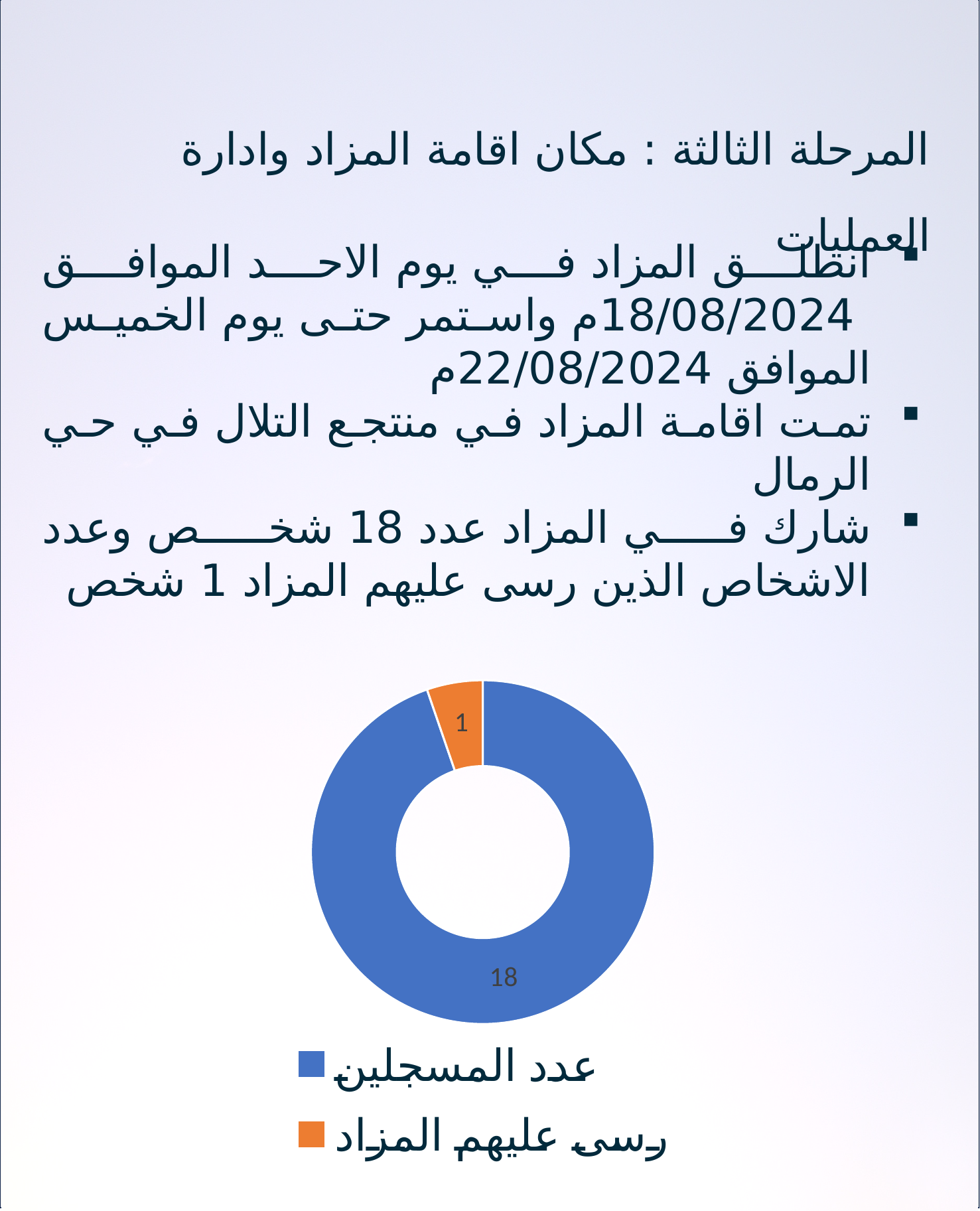
Which category has the smallest slice in the chart? رسى عليهم المزاد What kind of chart is shown on the slide? Doughnut chart What is the value for عدد المسجلين in the doughnut chart? 18 What colour is the slice for عدد المسجلين? Blue What colour is the slice for رسى عليهم المزاد? Orange Which is larger, the value for عدد المسجلين or the value for رسى عليهم المزاد? عدد المسجلين How many categories are shown in the chart? 2 What is the difference between the values for عدد المسجلين and رسى عليهم المزاد? 17 How many entries does the chart legend list? 2 What is the total of the two values shown in the chart? 19 What is the value for رسى عليهم المزاد in the doughnut chart? 1 Which category has the largest slice in the chart? عدد المسجلين